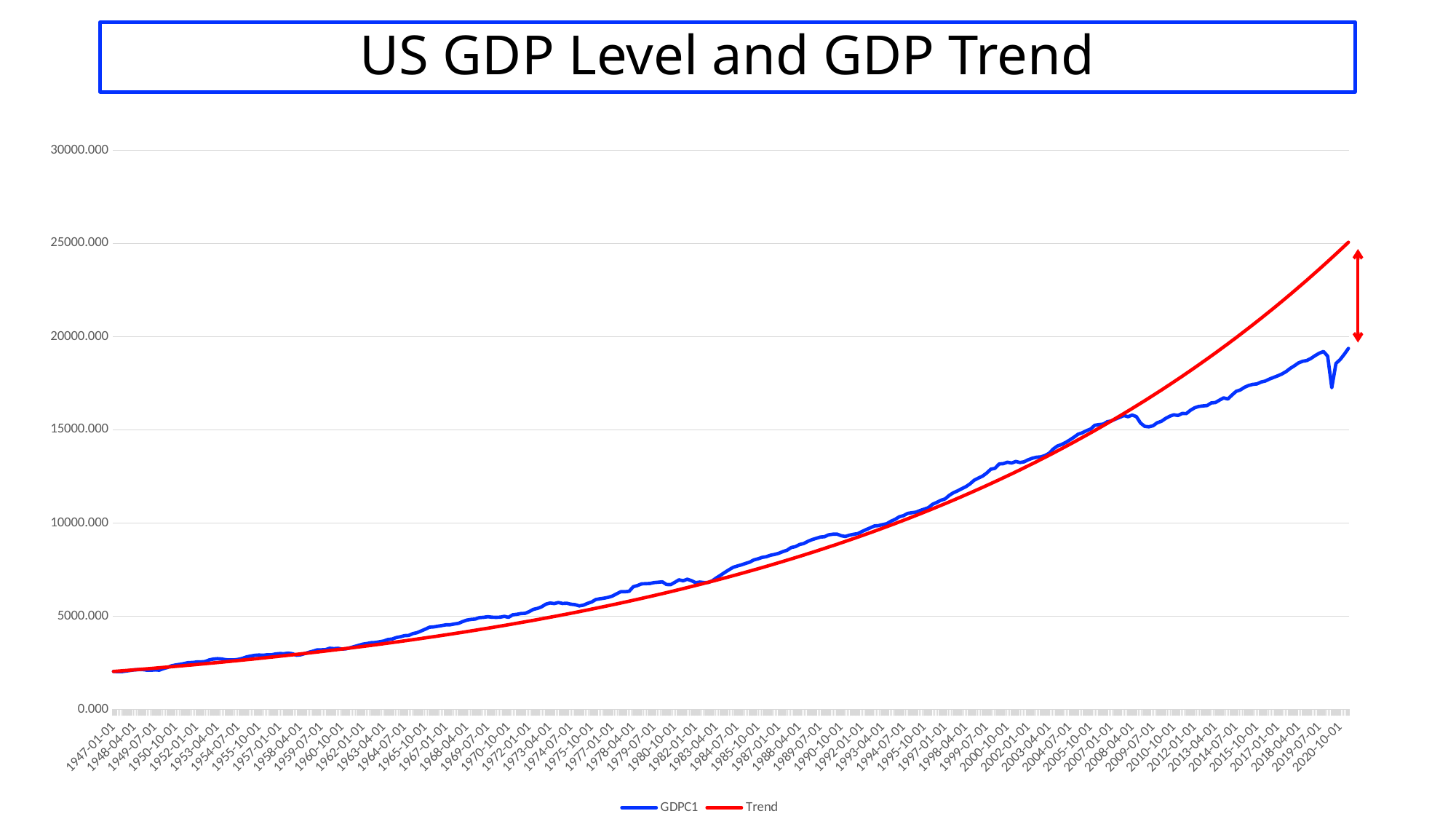
How many series does the legend list? 2 Is the Trend value at 2020-10-01 greater or less than 20000.000? greater At 1980-01-01, which series has the higher value, GDPC1 or Trend? GDPC1 Which series is drawn in red? Trend At 2020-10-01, which series has the higher value, GDPC1 or Trend? Trend What kind of chart is shown on the slide? Line chart Is the GDPC1 value at 2020-10-01 greater or less than 20000.000? less Is the GDPC1 value at 1947-01-01 greater or less than 5000.000? less What is the title of the chart? US GDP Level and GDP Trend Do the GDPC1 values generally rise or fall from 1947-01-01 to 2020-10-01? Rise